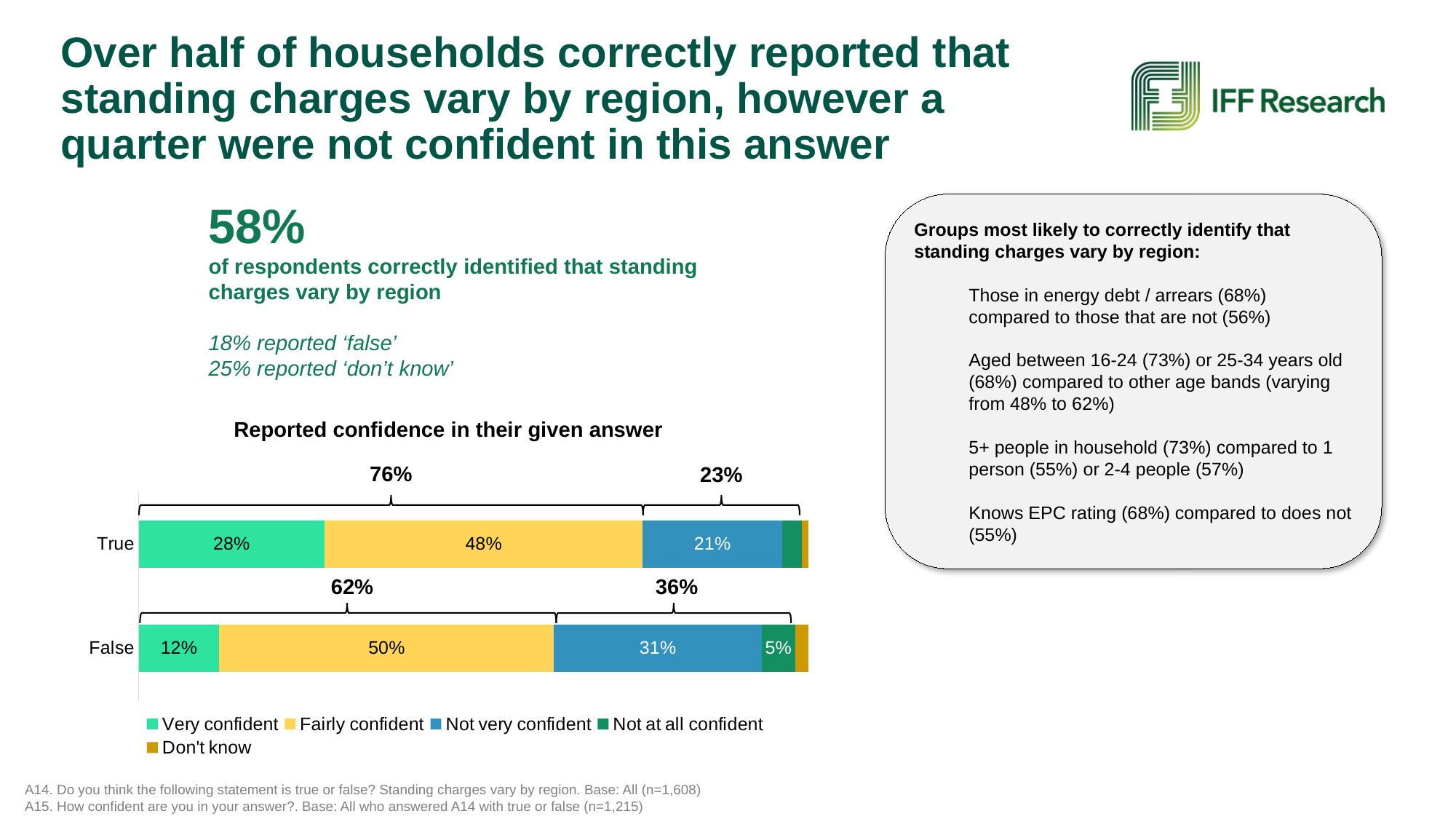
How many categories (bars) are shown in the chart? 2 What percentage of those who answered 'False' were fairly confident? 50% What kind of chart is 'Reported confidence in their given answer'? Stacked bar chart What percentage of those who answered 'True' were very confident? 28% How many series does the legend list? 5 What is the difference between the 'Not very confident' shares for 'False' and 'True'? 10 percentage points What percentage of those who answered 'False' were not at all confident? 5% Which answer group has the larger 'Very confident' share, True or False? True What percentage of those who answered 'True' were not very confident? 21% What combined percentage of 'True' respondents were very or fairly confident, as shown by the bracket label? 76% Which confidence level is the largest segment in the 'True' bar? Fairly confident What colour represents 'Don't know' in the legend? Dark yellow/gold